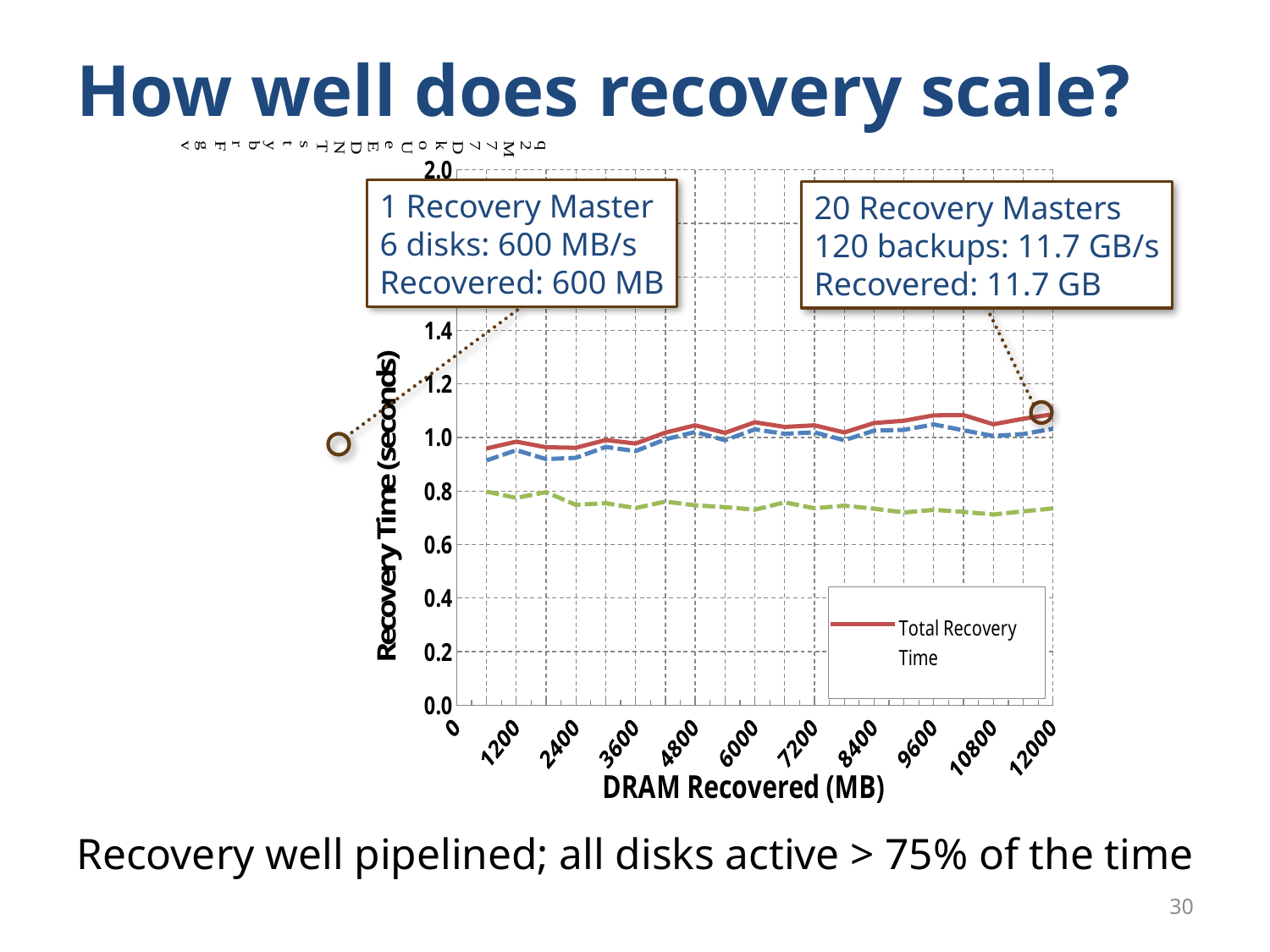
Is the value of the blue dashed line at 1200 MB of DRAM recovered greater or less than 1.0 seconds? less How many lines are plotted on the chart? 3 What kind of chart is shown on the slide? line chart How many series does the chart's legend list? 1 Is the Total Recovery Time at any point on the chart greater or less than 1.2 seconds? less What is the title of the x axis of the chart? DRAM Recovered (MB) Does the Total Recovery Time line generally rise or fall as DRAM Recovered increases from 1200 MB to 12000 MB? rise What is the title of the y axis of the chart? Recovery Time (seconds) Is the Total Recovery Time at 12000 MB of DRAM recovered greater or less than 1.0 seconds? greater At 6000 MB of DRAM recovered, which line has the larger value: the red Total Recovery Time line or the green dashed line? the red Total Recovery Time line How many labelled tick marks are on the x axis of the chart? 11